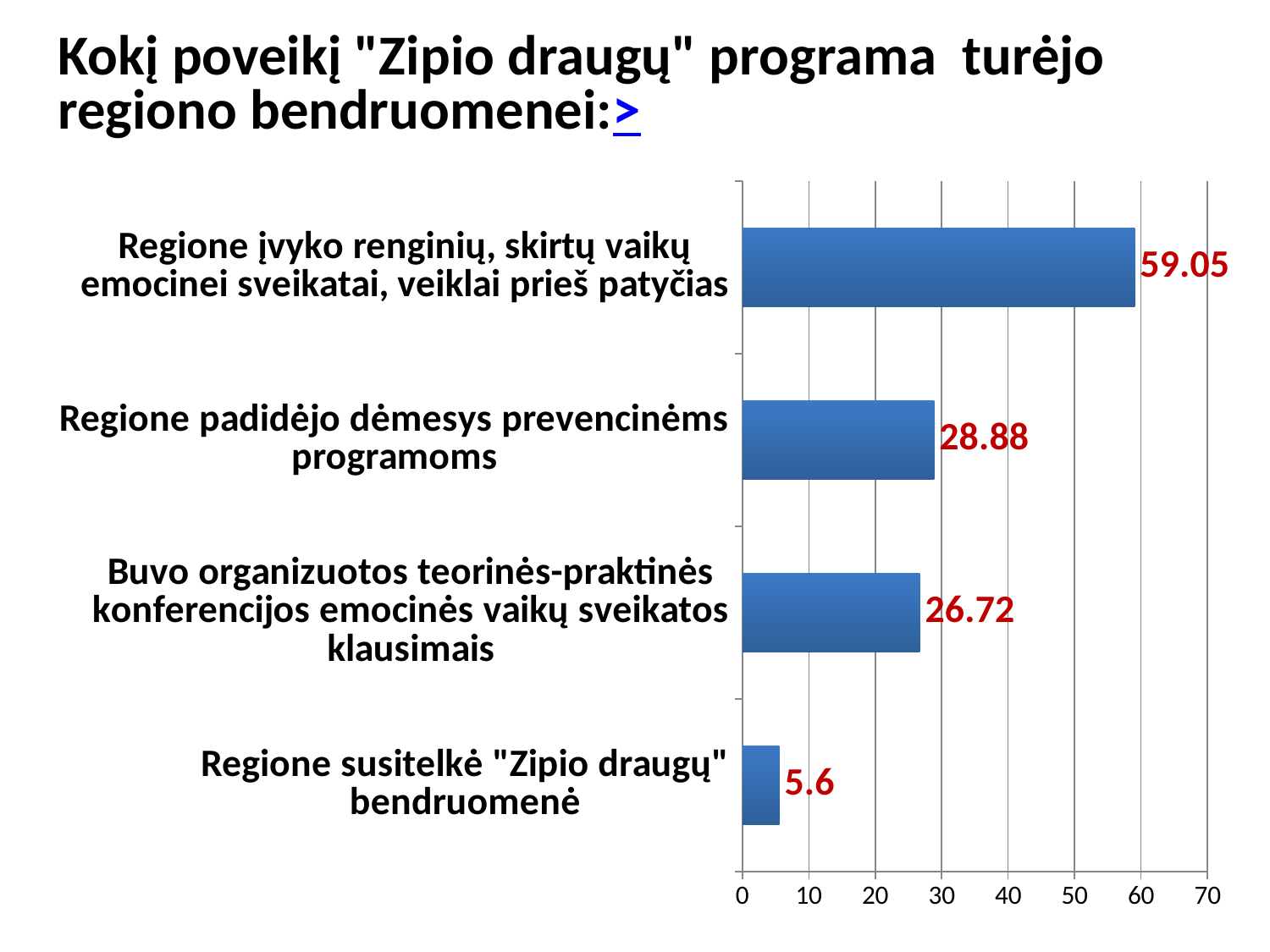
What is the value for "Buvo organizuotos teorinės-praktinės konferencijos emocinės vaikų sveikatos klausimais"? 26.72 Which category has the lowest value? Regione susitelkė "Zipio draugų" bendruomenė What is the difference between the values for "Regione padidėjo dėmesys prevencinėms programoms" and "Buvo organizuotos teorinės-praktinės konferencijos emocinės vaikų sveikatos klausimais"? 2.16 What is the value for "Regione įvyko renginių, skirtų vaikų emocinei sveikatai, veiklai prieš patyčias"? 59.05 Which is larger: the value for "Regione padidėjo dėmesys prevencinėms programoms" or the value for "Regione susitelkė "Zipio draugų" bendruomenė"? Regione padidėjo dėmesys prevencinėms programoms What is the value for "Regione susitelkė "Zipio draugų" bendruomenė"? 5.6 How many categories are shown in the chart? 4 Is the value for "Buvo organizuotos teorinės-praktinės konferencijos emocinės vaikų sveikatos klausimais" greater or less than 30? less Which category has the highest value? Regione įvyko renginių, skirtų vaikų emocinei sveikatai, veiklai prieš patyčias What kind of chart is shown on the slide? bar chart What is the difference between the values for "Regione įvyko renginių, skirtų vaikų emocinei sveikatai, veiklai prieš patyčias" and "Regione padidėjo dėmesys prevencinėms programoms"? 30.17 What is the value for "Regione padidėjo dėmesys prevencinėms programoms"? 28.88